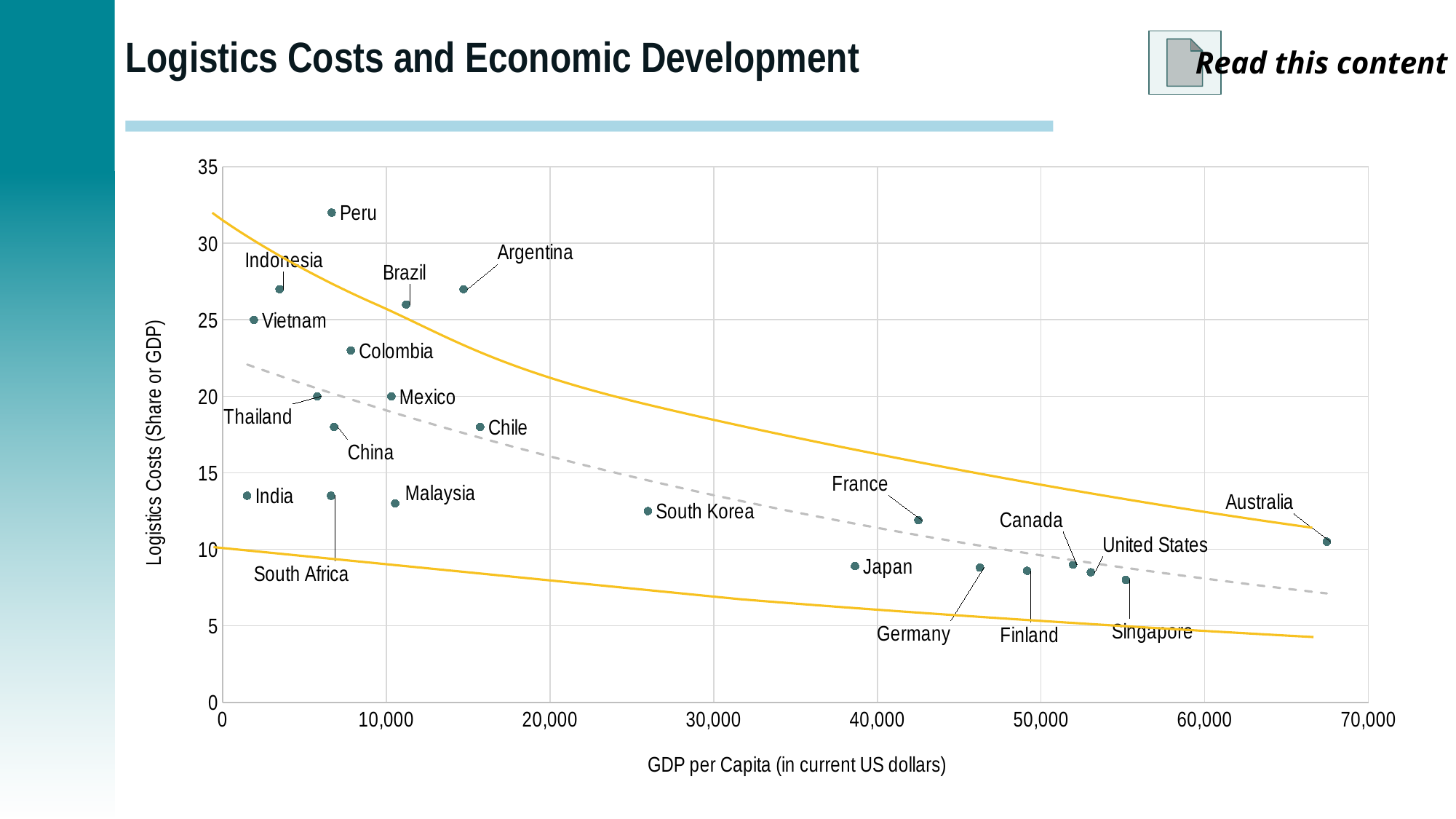
Is the logistics cost value for Peru greater or less than 30? greater What is the title of the x axis? GDP per Capita (in current US dollars) Is the logistics cost value for Japan greater or less than 10? less Which country has the highest GDP per capita on the chart? Australia Which country has the highest logistics costs on the chart? Peru Do logistics costs generally rise or fall as GDP per capita increases? Fall Which has higher logistics costs, Peru or Brazil? Peru Is the GDP per capita for Australia greater or less than 60,000? greater How many countries are plotted on the chart? 22 Which has higher logistics costs, Mexico or Chile? Mexico What kind of chart is shown on the slide? Scatter chart